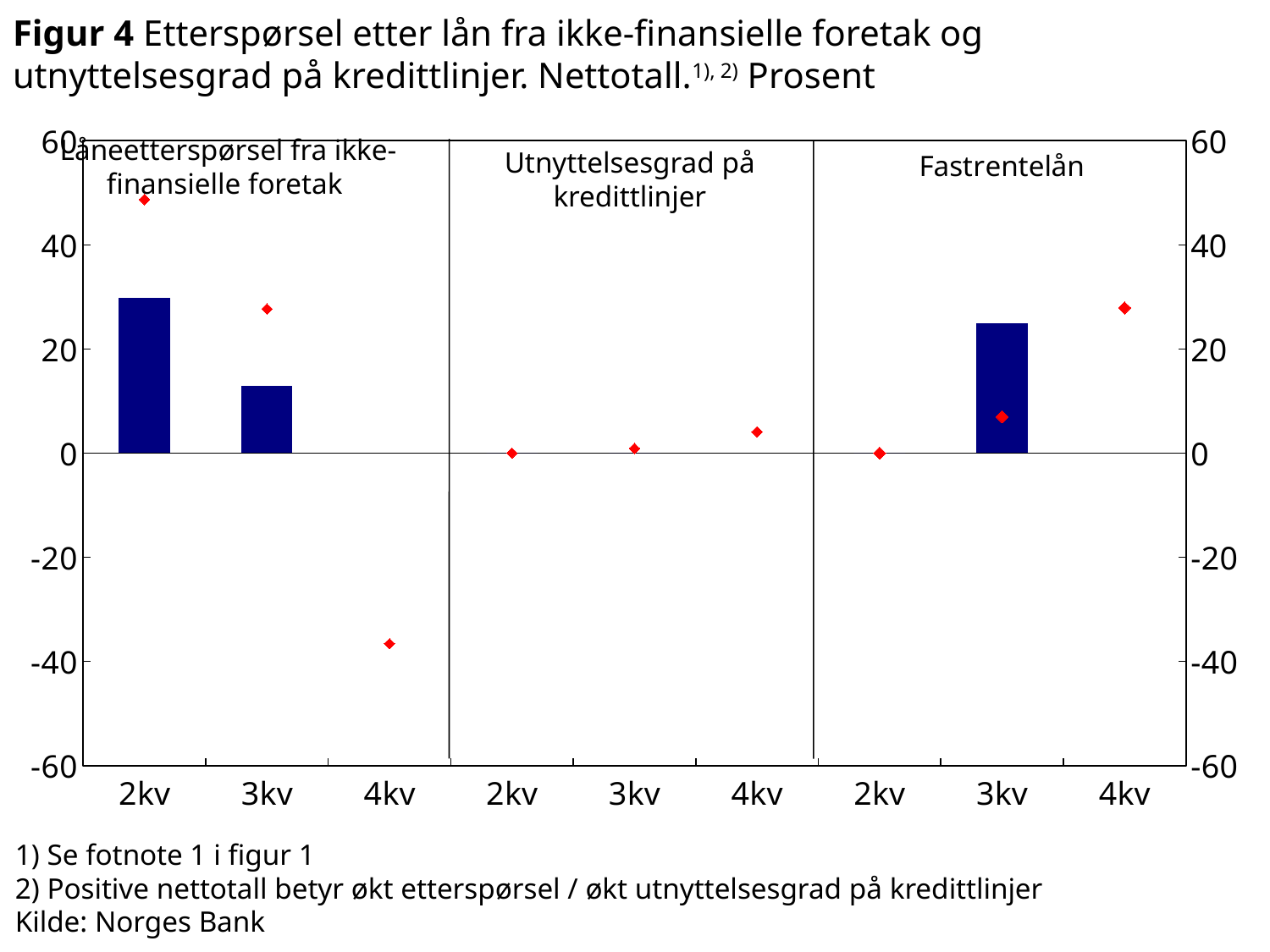
In the panel 'Låneetterspørsel fra ikke-finansielle foretak', which quarter has the larger bar, 2kv or 3kv? 2kv What is the title of the rightmost panel of the chart? Fastrentelån In the panel 'Låneetterspørsel fra ikke-finansielle foretak', is the red marker for 4kv greater or less than -20? less In the panel 'Fastrentelån', which quarter has the highest red marker? 4kv In the panel 'Fastrentelån', is the bar for 3kv greater or less than 20? greater In the panel 'Låneetterspørsel fra ikke-finansielle foretak', which quarter has the lowest red marker? 4kv How many panels (sections) does the chart have? 3 In the panel 'Låneetterspørsel fra ikke-finansielle foretak', is the bar for 2kv greater or less than 20? greater What is the title of the middle panel of the chart? Utnyttelsesgrad på kredittlinjer What kind of chart is shown on the slide? combination chart with bars and red diamond markers